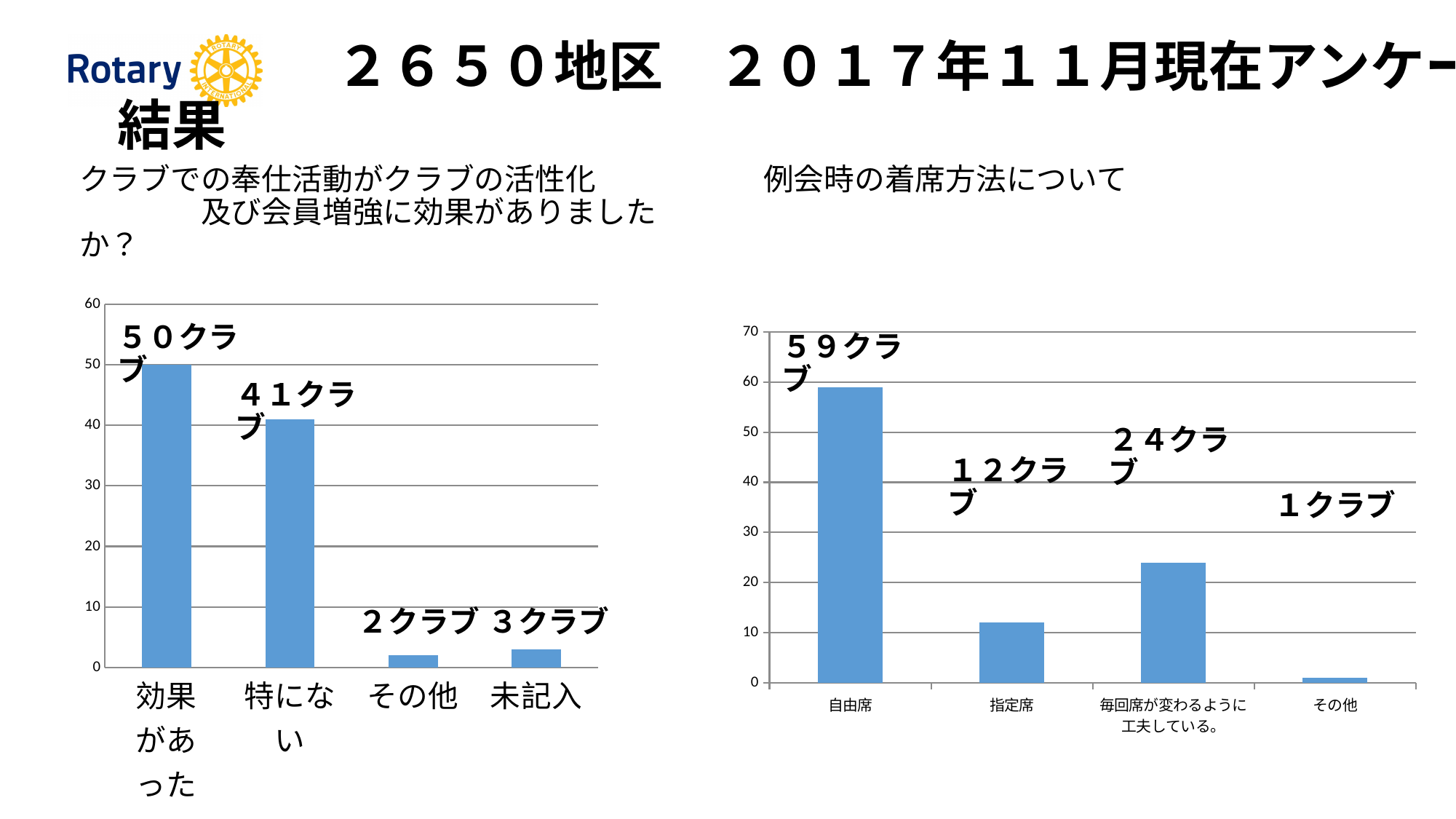
In the right chart (例会時の着席方法について), which is larger, 指定席 or 毎回席が変わるように工夫している。? 毎回席が変わるように工夫している。 In the right chart (例会時の着席方法について), what is the value for その他? １クラブ In the right chart (例会時の着席方法について), which category has the highest value? 自由席 In the right chart (例会時の着席方法について), what is the difference between 自由席 and 指定席? ４７クラブ In the left chart (クラブでの奉仕活動がクラブの活性化及び会員増強に効果がありましたか？), what is the value for 効果があった? ５０クラブ In the right chart (例会時の着席方法について), what is the value for 自由席? ５９クラブ In the left chart (クラブでの奉仕活動がクラブの活性化及び会員増強に効果がありましたか？), what is the difference between 効果があった and 特にない? ９クラブ In the right chart (例会時の着席方法について), what is the value for 毎回席が変わるように工夫している。? ２４クラブ In the left chart (クラブでの奉仕活動がクラブの活性化及び会員増強に効果がありましたか？), what is the value for 特にない? ４１クラブ In the right chart (例会時の着席方法について), what kind of chart is this? bar chart In the left chart (クラブでの奉仕活動がクラブの活性化及び会員増強に効果がありましたか？), which category has the lowest value? その他 In the left chart (クラブでの奉仕活動がクラブの活性化及び会員増強に効果がありましたか？), how many categories are shown? 4